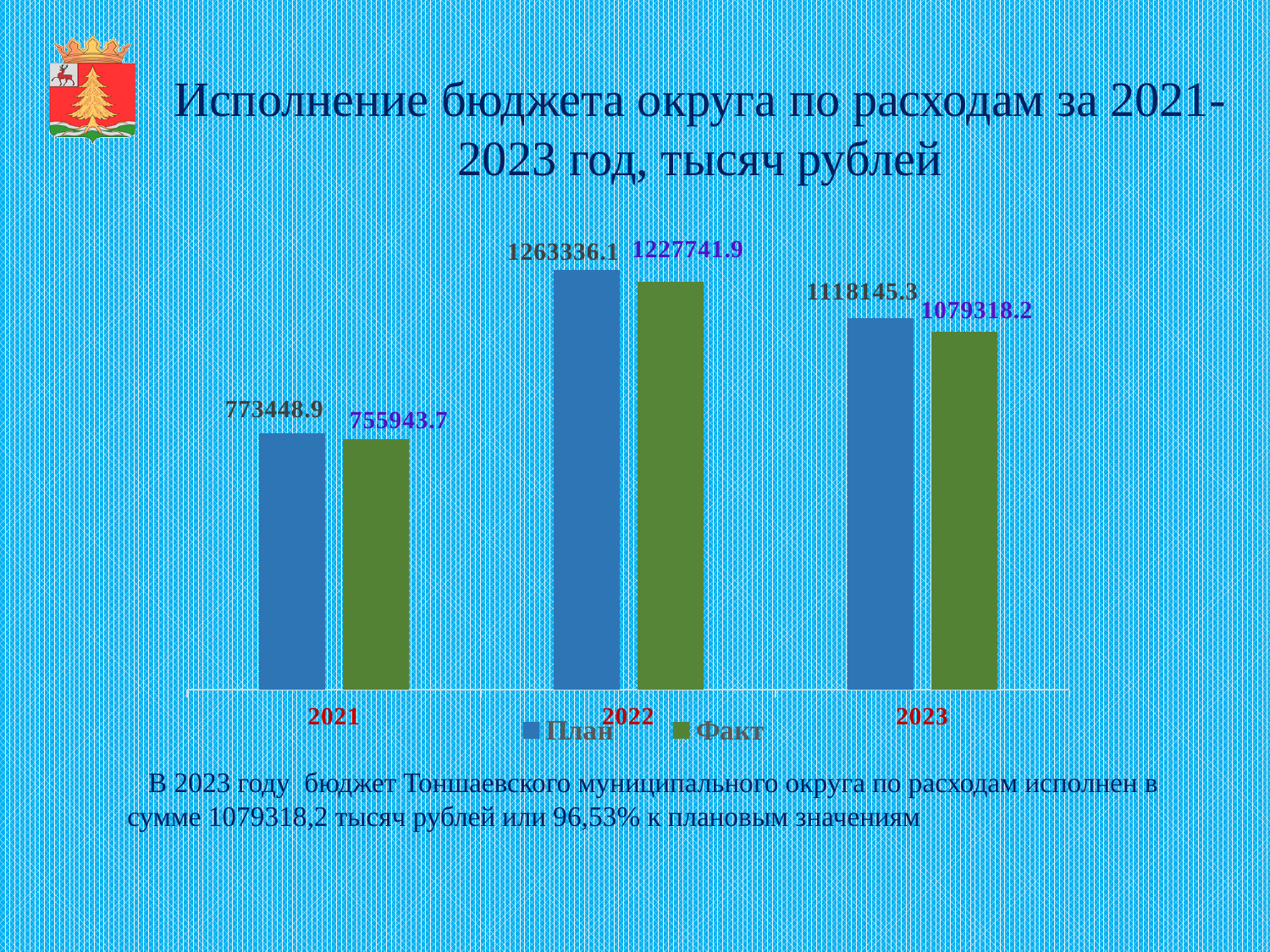
What is the План value for 2023? 1118145.3 What is the difference between the План and Факт values for 2021? 17505.2 What is the Факт value for 2023? 1079318.2 What is the difference between the План and Факт values for 2023? 38827.1 Which is larger for 2022, the План value or the Факт value? План What is the План value for 2022? 1263336.1 How many series does the legend list? 2 What kind of chart is shown on the slide? Bar chart In which year is the План value lowest? 2021 How many years are shown on the x axis? 3 What is the Факт value for 2021? 755943.7 In which year is the Факт value highest? 2022